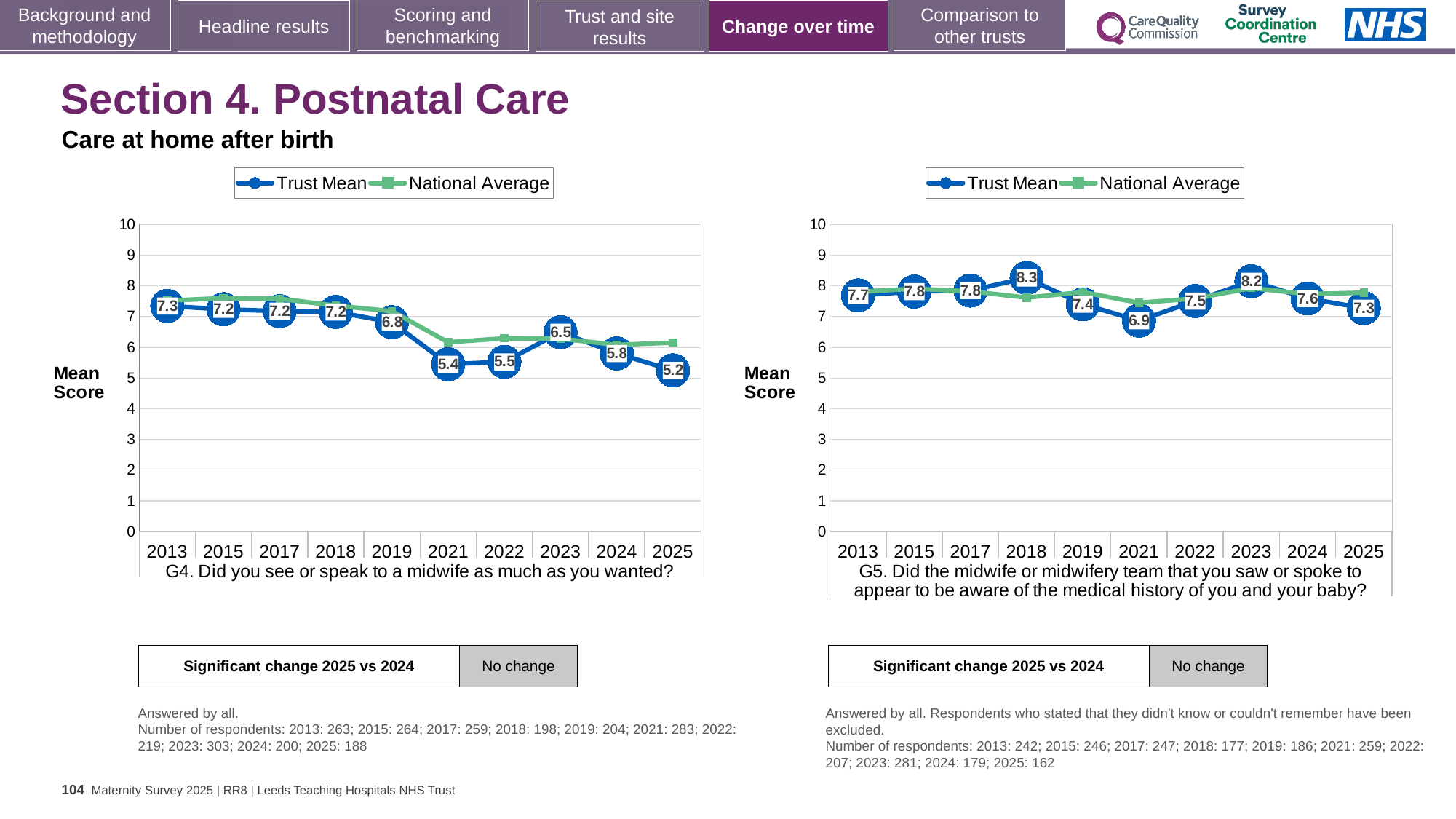
How many years are plotted on the x axis of the G4 chart (left)? 10 How many series does the legend of the G5 chart (right) list? 2 In the G5 chart (right), what is the Trust Mean score for 2018? 8.3 In the G4 chart (left), what is the difference between the Trust Mean scores for 2013 and 2025? 2.1 In the G4 chart (left), is the National Average for 2025 greater or less than 5? greater What kind of chart is the G4 chart (left)? Line chart In the G4 chart (left), what is the Trust Mean score for 2025? 5.2 In the G4 chart (left), which year has the lowest Trust Mean score? 2025 In the G5 chart (right), which is larger, the Trust Mean for 2023 or for 2024? 2023 In the G5 chart (right), what is the difference between the Trust Mean scores for 2018 and 2021? 1.4 In the G4 chart (left), which year has the highest Trust Mean score? 2013 In the G5 chart (right), which year has the lowest Trust Mean score? 2021